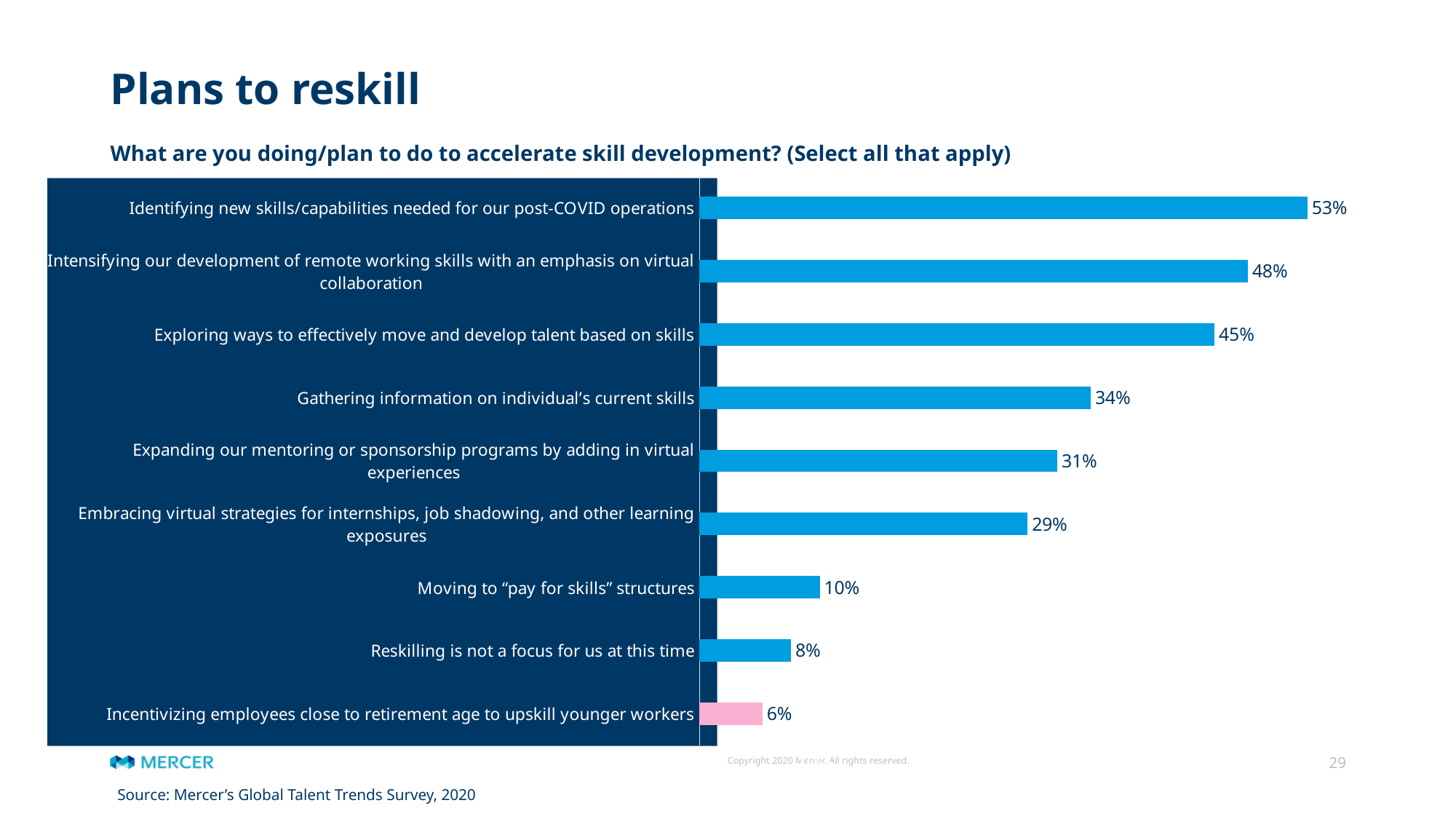
Which category has the lowest value in the chart? Incentivizing employees close to retirement age to upskill younger workers What kind of chart is shown on the slide? Bar chart What is the difference between the value for intensifying development of remote working skills and the value for gathering information on individuals' current skills? 14% Which category has the highest value in the chart? Identifying new skills/capabilities needed for our post-COVID operations What is the value for 'Moving to "pay for skills" structures'? 10% How many categories are shown in the chart? 9 What percentage of respondents are identifying new skills/capabilities needed for their post-COVID operations? 53% Which bar in the chart is coloured pink rather than blue? Incentivizing employees close to retirement age to upskill younger workers What percentage said reskilling is not a focus for them at this time? 8% What is the source cited for the chart? Mercer's Global Talent Trends Survey, 2020 Which is larger: the value for expanding mentoring or sponsorship programs with virtual experiences, or the value for embracing virtual strategies for internships and job shadowing? Expanding our mentoring or sponsorship programs by adding in virtual experiences What is the value for 'Exploring ways to effectively move and develop talent based on skills'? 45%